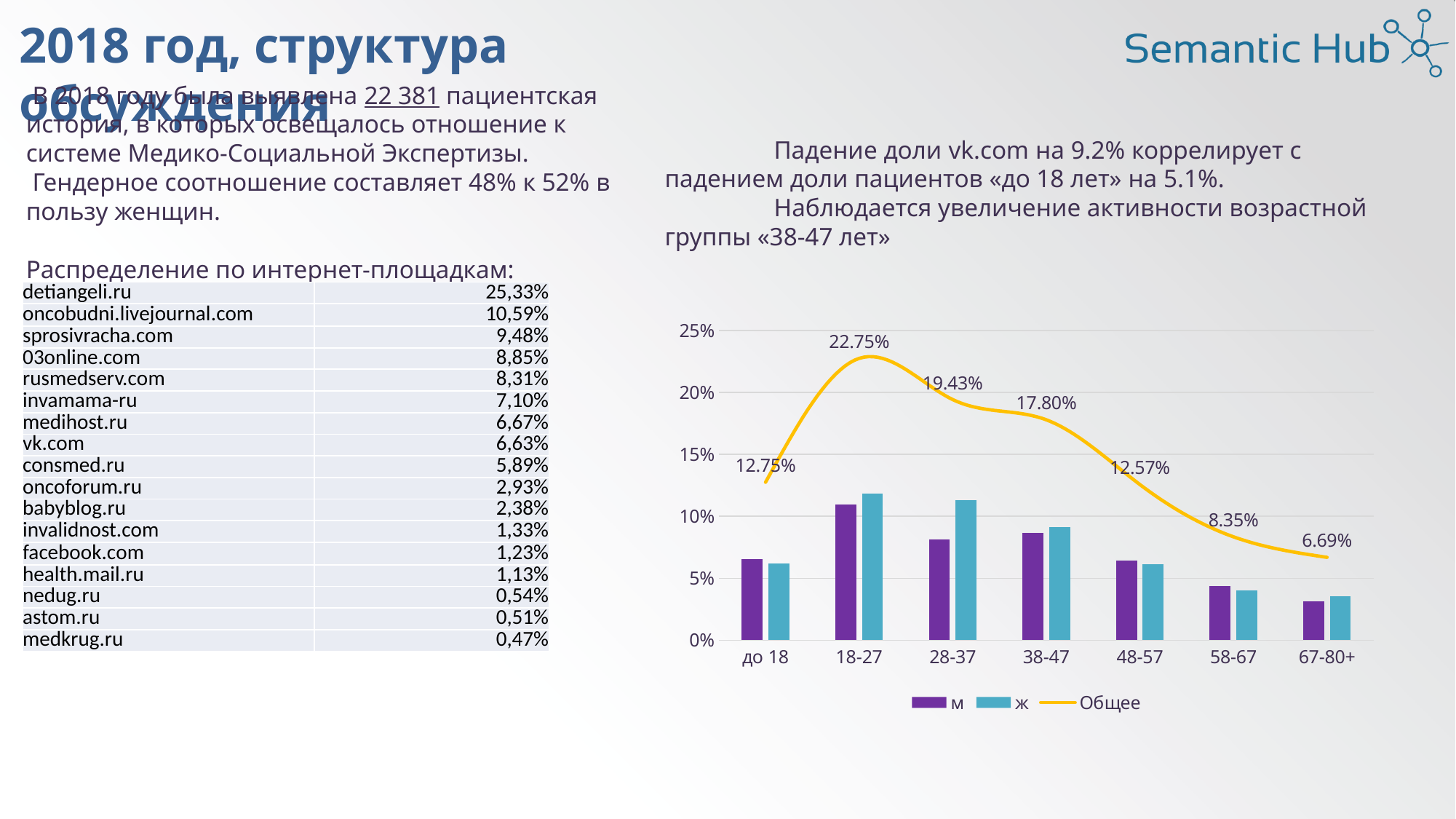
What is the difference between the Общее values for 18-27 and 28-37? 3.32% Is the value of the ж bar for the 67-80+ age group greater or less than 5%? less Which has the larger Общее value, 28-37 or 38-47? 28-37 What is the value of the Общее line for the 67-80+ age group? 6.69% Is the value of the м bar for the 18-27 age group greater or less than 10%? greater What is the value of the Общее line for the 18-27 age group? 22.75% How many age groups are shown on the x axis of the chart? 7 Which age group has the lowest value on the Общее line? 67-80+ Which age group has the highest value on the Общее line? 18-27 Does the Общее line rise or fall from the 18-27 group to the 67-80+ group? fall What is the value of the Общее line for the 38-47 age group? 17.80% How many series does the chart legend list? 3